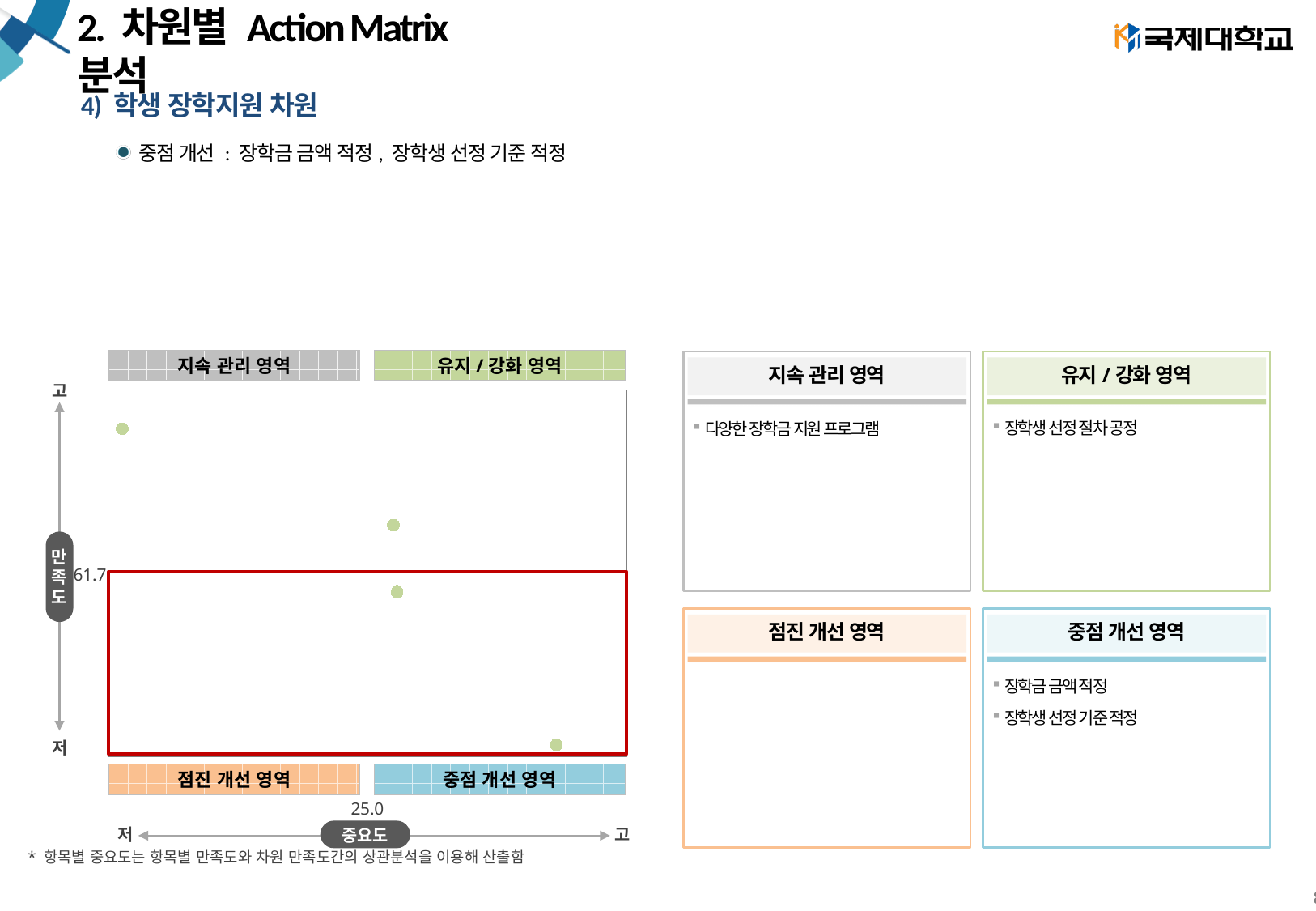
Is the 만족도 value of the point in the top-left quadrant greater or less than 61.7? greater How many data points fall in the 점진 개선 영역 (bottom-left) quadrant of the chart? 0 How many data points are plotted in the action matrix chart? 4 Which quadrant of the chart is outlined with a red border? 점진 개선 영역 and 중점 개선 영역 (the whole bottom half) How many data points fall in the 중점 개선 영역 (bottom-right) quadrant of the chart? 2 What kind of chart is shown on the left of the slide? scatter chart What value marks the vertical reference line on the 중요도 axis of the chart? 25.0 What is the label of the vertical axis of the chart? 만족도 What value marks the horizontal reference line on the 만족도 axis of the chart? 61.7 Is the 중요도 value of the lowest point in the chart greater or less than 25.0? greater